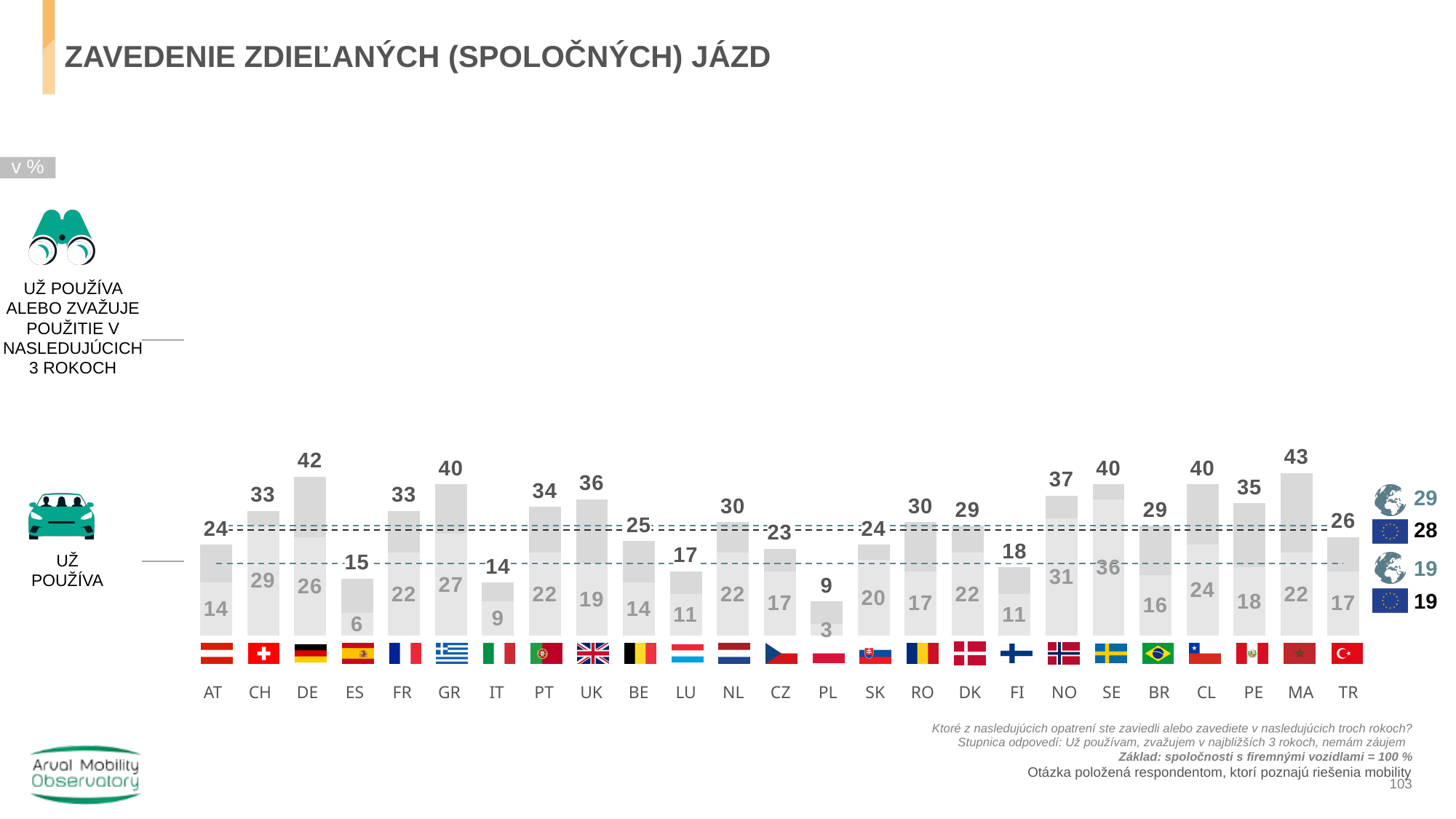
Which has a higher 'Už používa' value, NO or CL? NO How many countries are shown on the x axis of the chart? 25 What is the EU average value shown for the 'Už používa alebo zvažuje použitie v nasledujúcich 3 rokoch' series? 28 What is the difference between the 'Už používa alebo zvažuje' value and the 'Už používa' value for UK? 17 What is the difference between the 'Už používa alebo zvažuje' values of MA and TR? 17 What is the value for DE in the 'Už používa alebo zvažuje použitie v nasledujúcich 3 rokoch' series? 42 What type of chart is shown on the slide? bar chart What is the global average value shown for the 'Už používa' series? 19 What is the 'Už používa' value for SE? 36 What is the 'Už používa alebo zvažuje použitie v nasledujúcich 3 rokoch' value for PL? 9 Which country has the highest value in the 'Už používa alebo zvažuje použitie v nasledujúcich 3 rokoch' series? MA Which country has the lowest 'Už používa' value? PL